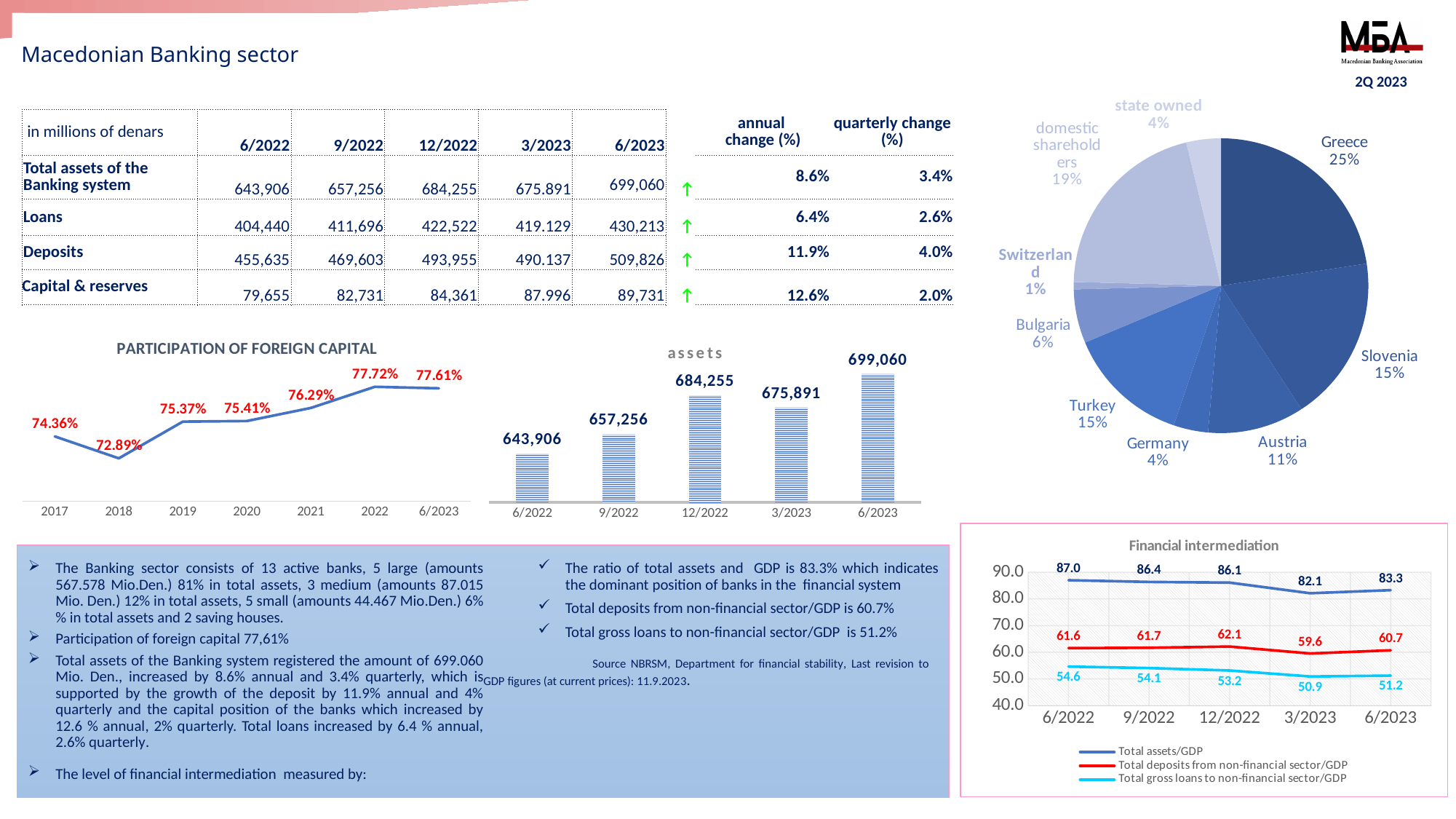
In the 'assets' bar chart, which period has the lowest value? 6/2022 In the 'PARTICIPATION OF FOREIGN CAPITAL' chart, what is the value for 2018? 72.89% In the 'assets' bar chart, what is the difference between the 12/2022 and 3/2023 values? 8,364 In the 'PARTICIPATION OF FOREIGN CAPITAL' chart, which year has the highest value? 2022 How many series does the legend of the 'Financial intermediation' chart list? 3 How many slices does the pie chart on the right have? 9 In the 'assets' bar chart, what is the value for 6/2023? 699,060 In the 'Financial intermediation' chart, is the Total gross loans to non-financial sector/GDP value for 6/2022 greater or less than 60.0? less In the pie chart on the right, which slice is the smallest? Switzerland How many data points are plotted in the 'PARTICIPATION OF FOREIGN CAPITAL' chart? 7 In the pie chart on the right, what share does Greece hold? 25% In the 'Financial intermediation' chart, what is the Total assets/GDP value for 3/2023? 82.1